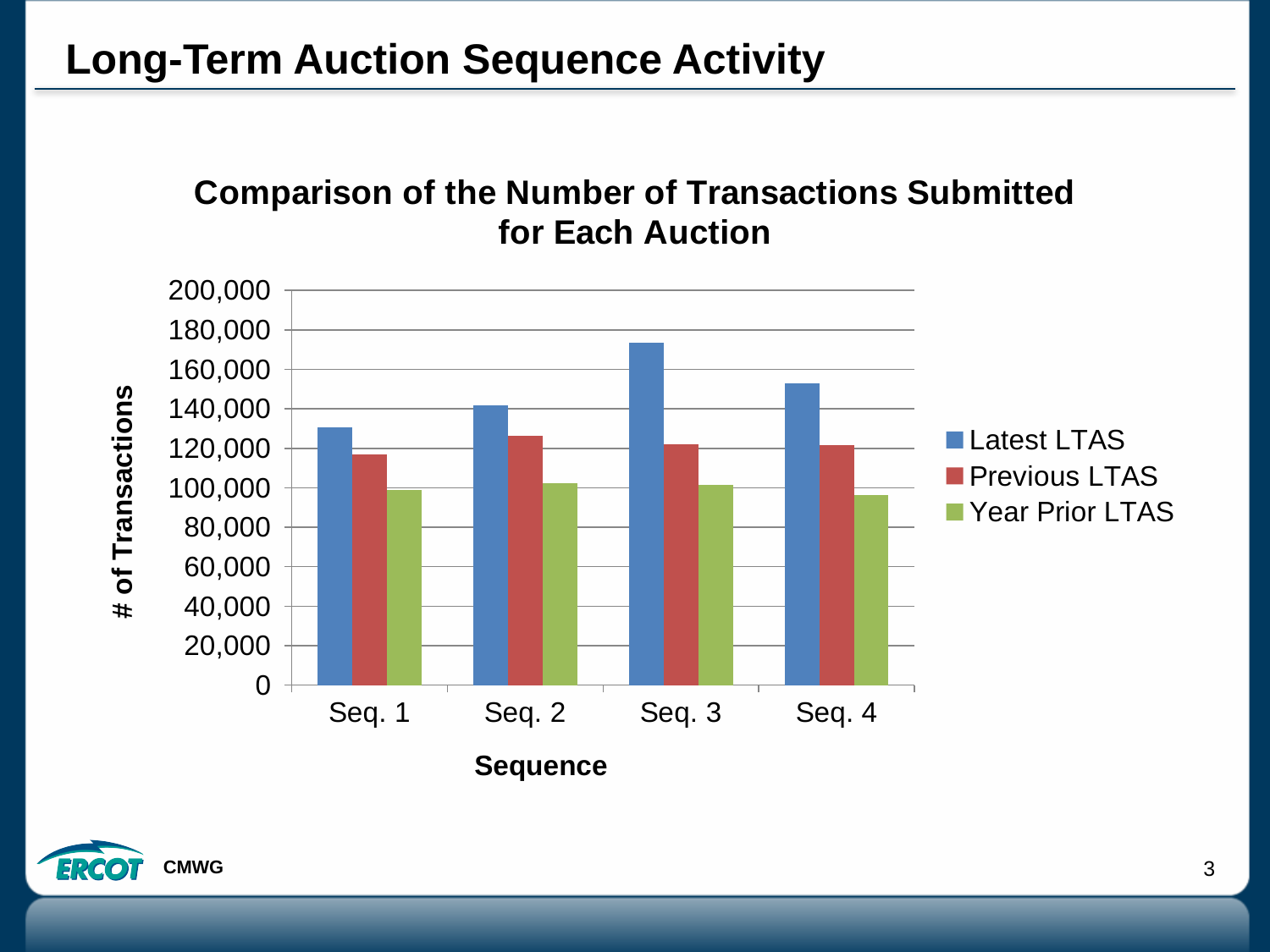
How many series does the legend list? 3 Is the Latest LTAS value for Seq. 4 greater or less than 140,000? greater Is the Previous LTAS value for Seq. 1 greater or less than 120,000? less Does the Latest LTAS value rise or fall from Seq. 1 to Seq. 3? rise What is the label on the y axis of the chart? # of Transactions For Seq. 3, which is larger: Latest LTAS or Previous LTAS? Latest LTAS Which sequence has the lowest Latest LTAS value? Seq. 1 Is the Latest LTAS value for Seq. 3 greater or less than 160,000? greater What kind of chart is shown on the slide? Bar chart Which sequence has the highest Latest LTAS value? Seq. 3 How many sequence categories are shown on the x axis? 4